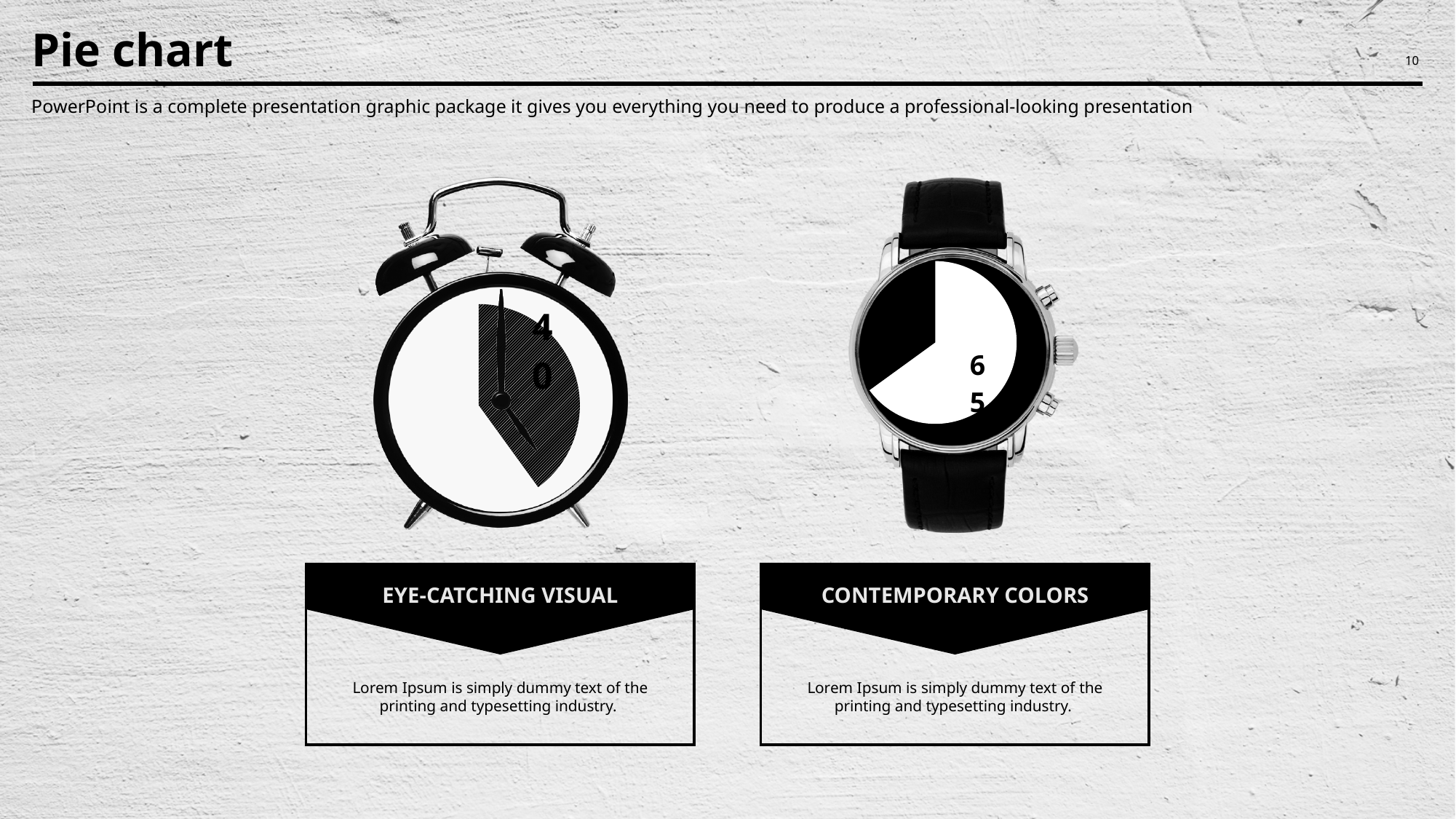
Which chart shows the larger printed value, the alarm clock chart on the left or the wristwatch chart on the right? the wristwatch chart on the right How many pie charts are shown on the slide? 2 What is the caption printed in the box below the alarm clock chart on the left? EYE-CATCHING VISUAL What kind of chart is shown inside the alarm clock and the wristwatch? pie chart What is the title of the slide? Pie chart What value is printed on the pie chart inside the wristwatch on the right? 65 What is the difference between the value on the wristwatch chart (65) and the value on the alarm clock chart (40)? 25 Is the value on the wristwatch chart on the right greater or less than 50? greater What value is printed on the pie chart inside the alarm clock on the left? 40 Is the value on the alarm clock chart on the left greater or less than 50? less